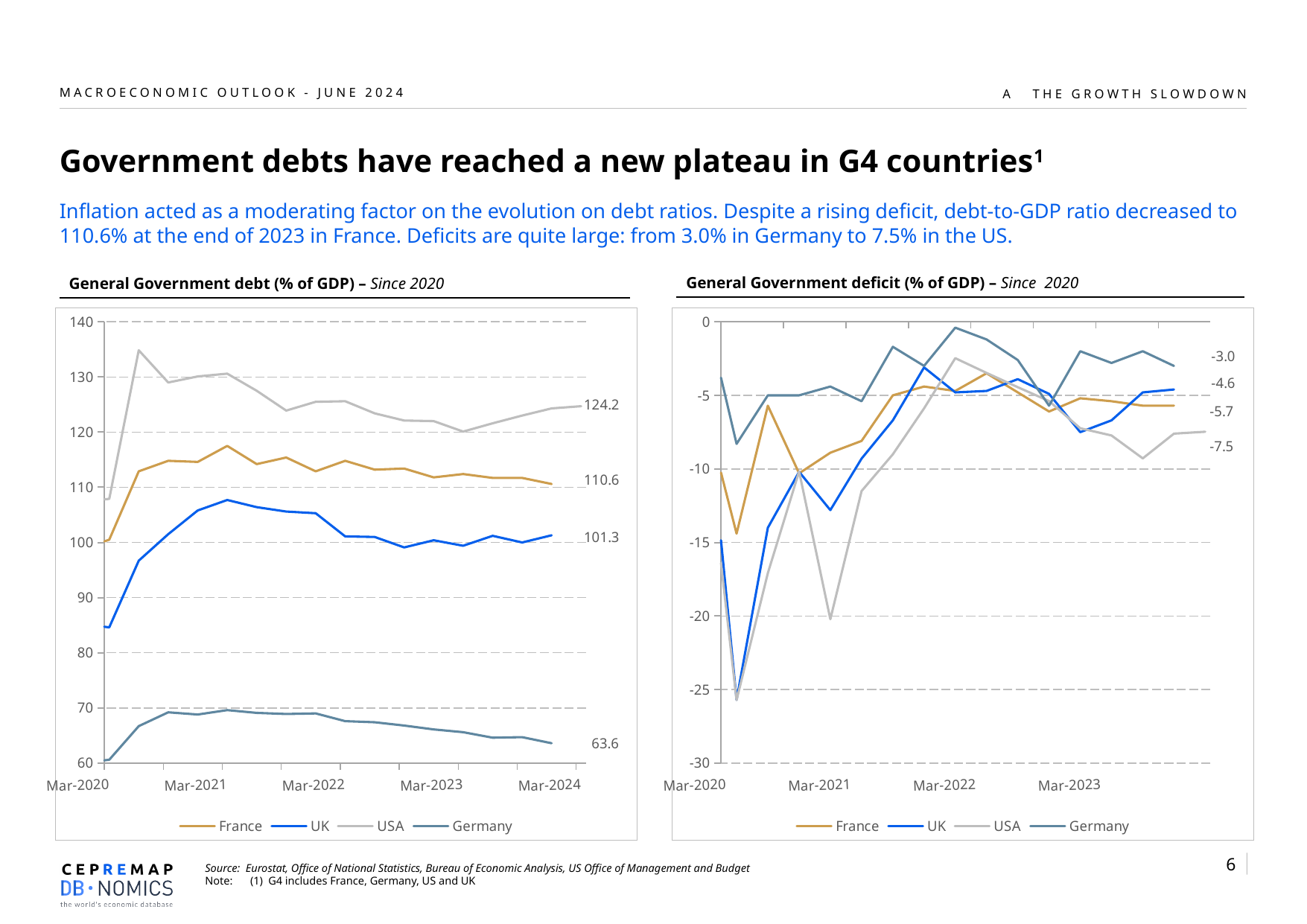
In the 'General Government debt (% of GDP)' chart, what is the difference between the latest values for France and the UK? 9.3 In the 'General Government debt (% of GDP)' chart, what is the latest value shown for Germany? 63.6 In the 'General Government debt (% of GDP)' chart, which country has the lowest debt ratio at the end of the series? Germany In the 'General Government debt (% of GDP)' chart, what is the latest value shown for the USA? 124.2 In the 'General Government debt (% of GDP)' chart, is the value for Germany at Mar-2020 greater or less than 70? less In the 'General Government deficit (% of GDP)' chart, what is the latest value shown for Germany? -3.0 In the 'General Government deficit (% of GDP)' chart, what is the latest value shown for the USA? -7.5 In the 'General Government debt (% of GDP)' chart, which country has the highest debt ratio at the end of the series? USA In the 'General Government deficit (% of GDP)' chart, is the latest value for the UK larger than the latest value for France? yes How many series does the legend of the 'General Government deficit (% of GDP)' chart list? 4 In the 'General Government debt (% of GDP)' chart, what is the latest value shown for France? 110.6 What kind of chart is the 'General Government debt (% of GDP)' chart? line chart